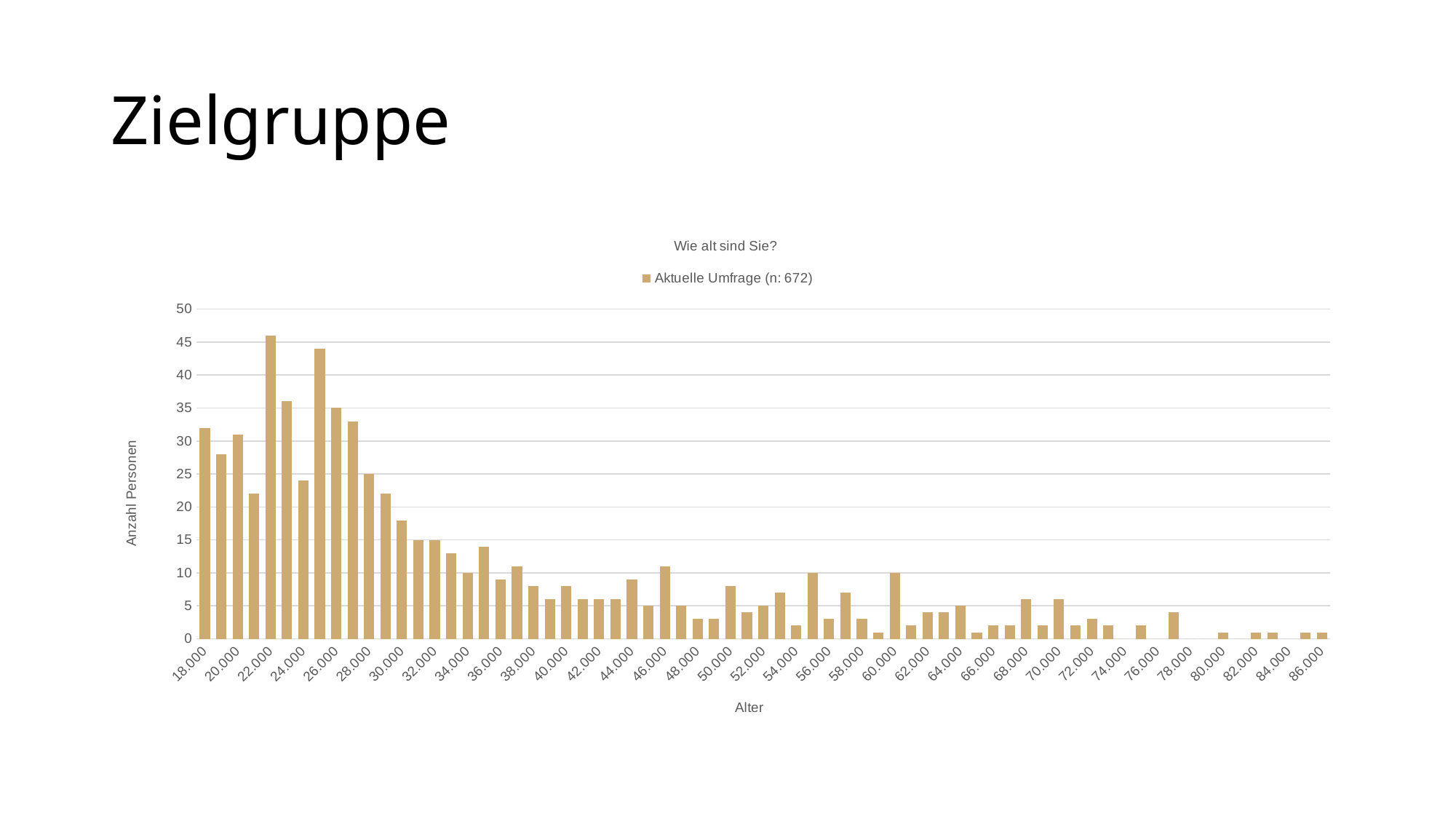
Is the value for 30.000 greater or less than 20? less What is the legend entry of the series in the chart? Aktuelle Umfrage (n: 672) What kind of chart is shown on the slide? bar chart Do the values generally rise or fall as age increases along the x axis? fall What is the title of the chart? Wie alt sind Sie? Is the value for 60.000 greater or less than 5? greater Is the value for 22.000 greater or less than 40? greater How many series does the chart legend list? 1 Which has the larger value, 22.000 or 30.000? 22.000